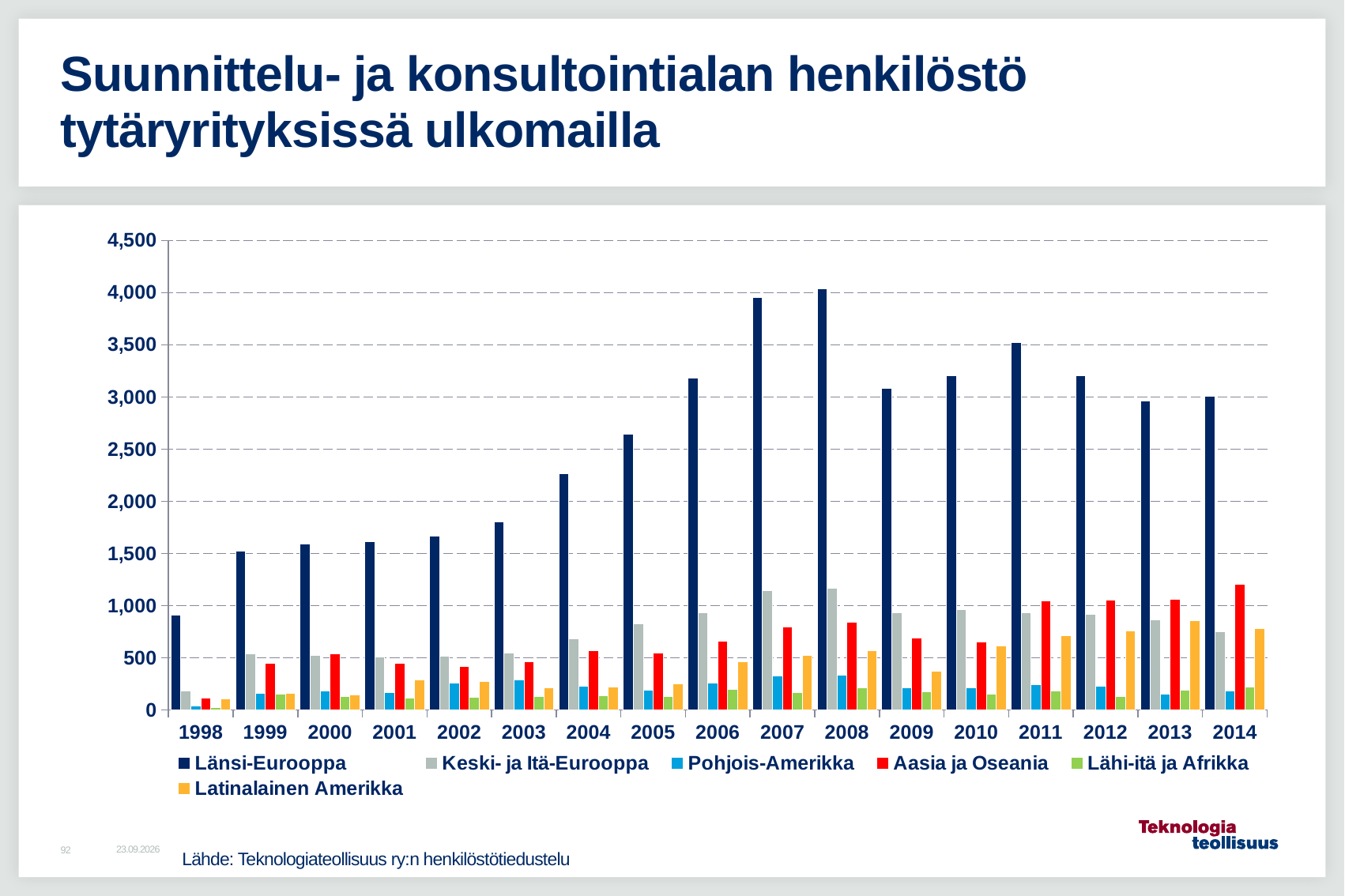
Is the value for Länsi-Eurooppa in 2004 greater or less than 2,000? greater Is the value for Länsi-Eurooppa in 2008 greater or less than 4,000? greater Does the value for Länsi-Eurooppa rise or fall from 1998 to 2008? rise In which year is the value for Aasia ja Oseania highest? 2014 In which year is the value for Länsi-Eurooppa lowest? 1998 Is the value for Länsi-Eurooppa in 1998 greater or less than 1,000? less What kind of chart is shown on the slide? bar chart How many years are shown on the x axis? 17 How many series does the legend list? 6 In 2014, which is larger: Aasia ja Oseania or Keski- ja Itä-Eurooppa? Aasia ja Oseania In which year is the value for Länsi-Eurooppa highest? 2008